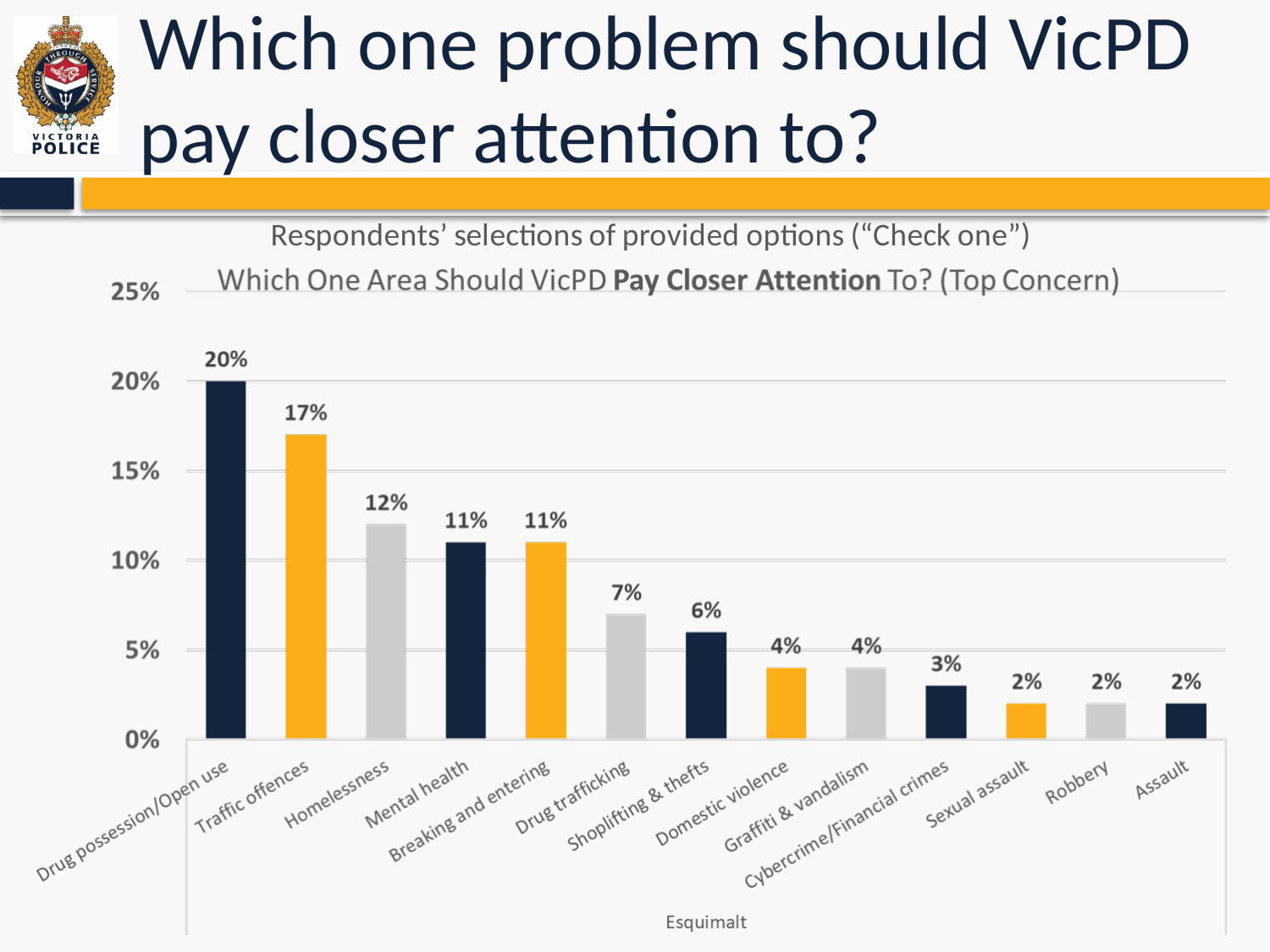
What is the difference between the values for Drug possession/Open use and Traffic offences? 3% What percentage of respondents selected Drug possession/Open use as the one problem VicPD should pay closer attention to? 20% Which is larger, the value for Drug trafficking or the value for Cybercrime/Financial crimes? Drug trafficking What is the difference between the values for Homelessness and Drug trafficking? 5% How many categories are shown on the x axis of the chart? 13 Which category has the highest value in the chart? Drug possession/Open use What kind of chart is shown on the slide? Bar chart What percentage is shown for Homelessness? 12% Which is larger, the value for Traffic offences or the value for Mental health? Traffic offences What value is shown for Shoplifting & thefts? 6% What value is shown for Traffic offences? 17% Do the values rise or fall moving from left to right along the x axis? Fall